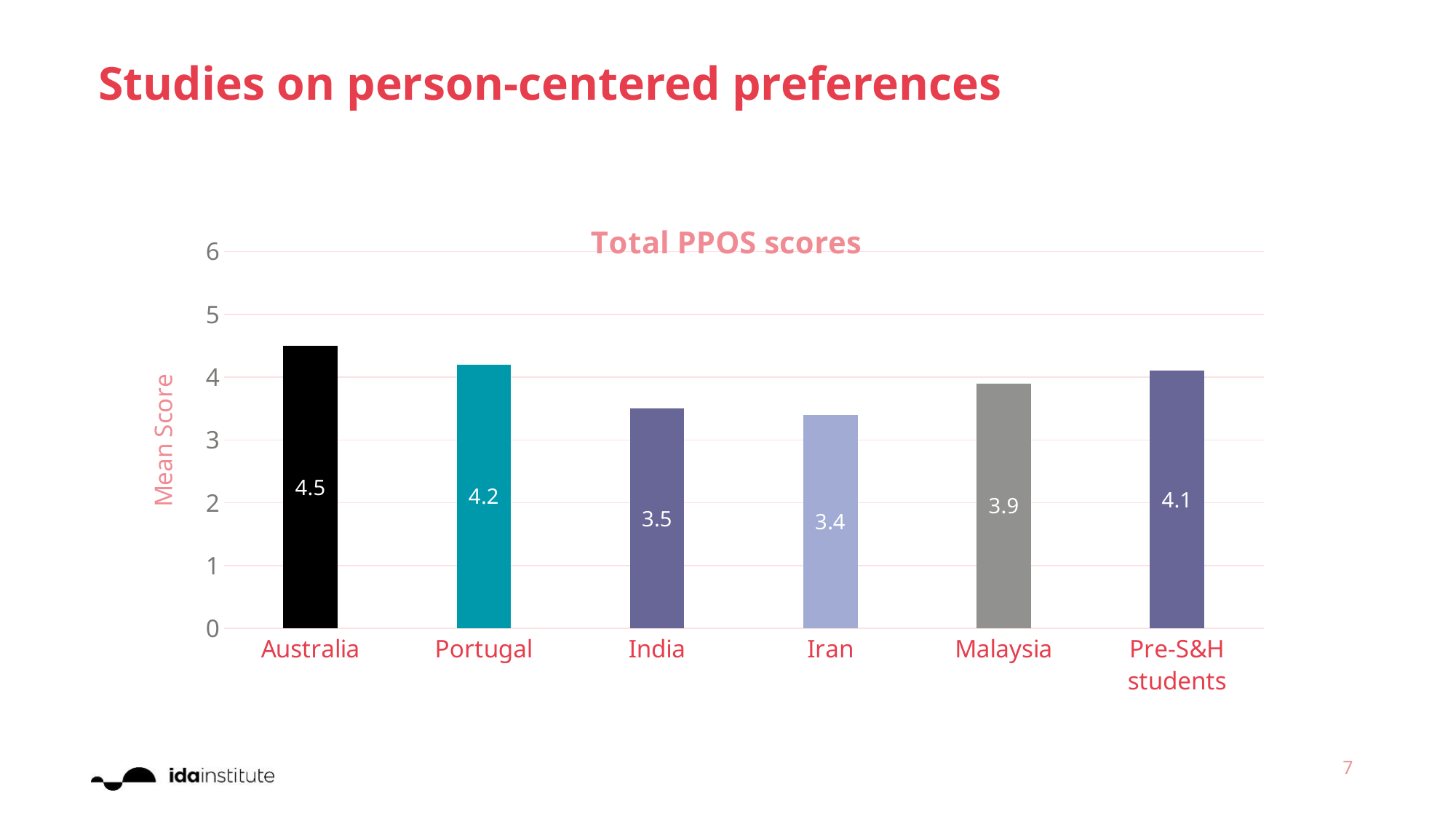
What is the mean score for Australia? 4.5 Which category has the highest total PPOS score? Australia What is the title of the chart? Total PPOS scores What is the mean score for Pre-S&H students? 4.1 What kind of chart is shown on the slide? Bar chart Is the value for India greater or less than 4? less What is the difference between the scores for Australia and India? 1 Which has a higher score, Portugal or Malaysia? Portugal How many categories are shown on the x axis? 6 What is the difference between the scores for Portugal and Malaysia? 0.3 What is the mean score for Iran? 3.4 Which category has the lowest total PPOS score? Iran